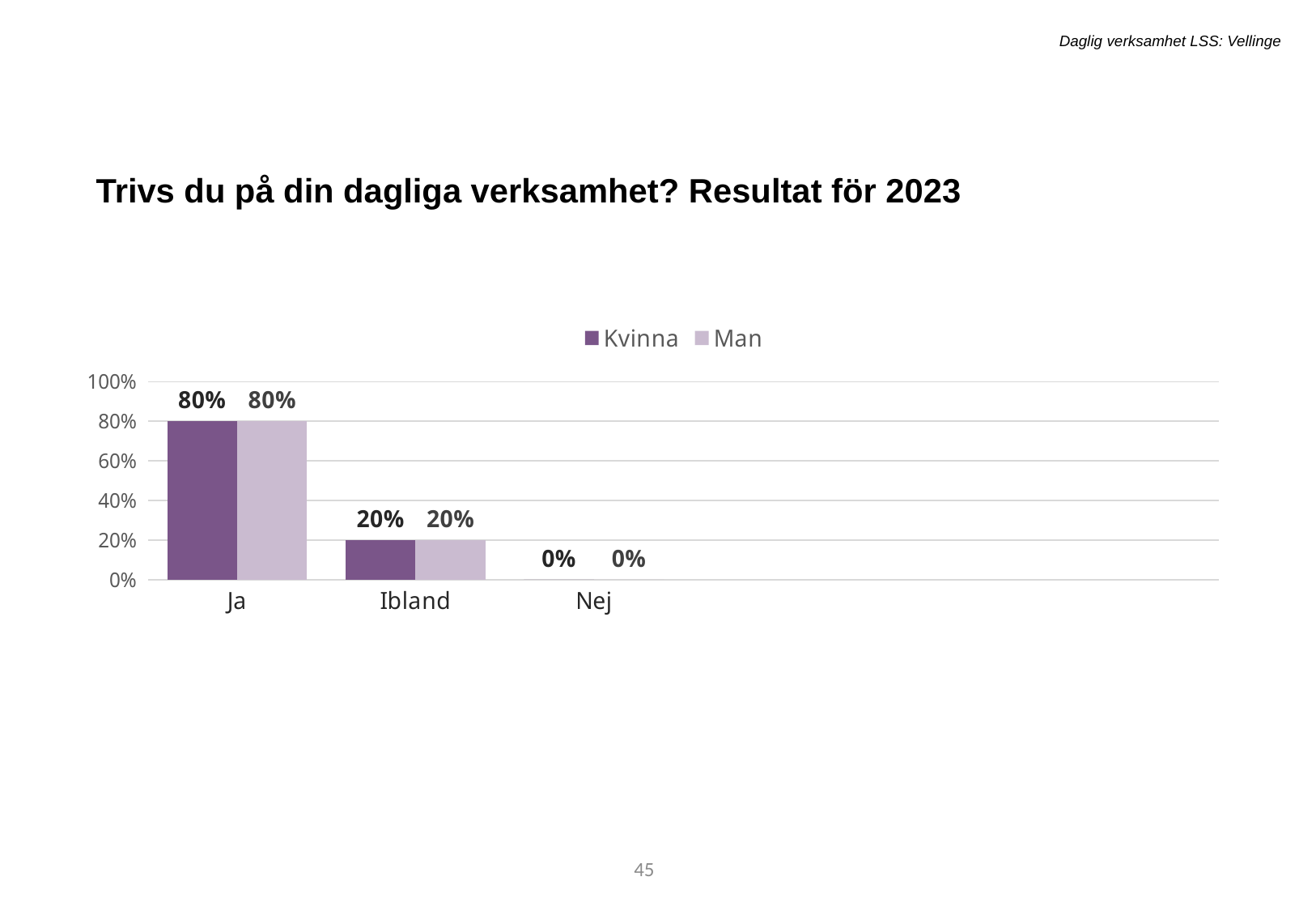
What kind of chart is shown on the slide? bar chart Is the value for Kvinna in the Ja category greater or less than 60%? greater Which is larger for Man: the value for Ja or the value for Ibland? Ja What are the two series named in the legend? Kvinna and Man How many categories are shown on the x axis? 3 What is the value for Kvinna in the Nej category? 0% What is the difference between the Kvinna values for Ja and Ibland? 60% Which category has the highest value for Man? Ja What is the value for Man in the Ibland category? 20% How many series does the legend list? 2 Which category has the lowest value for Kvinna? Nej What is the value for Kvinna in the Ja category? 80%